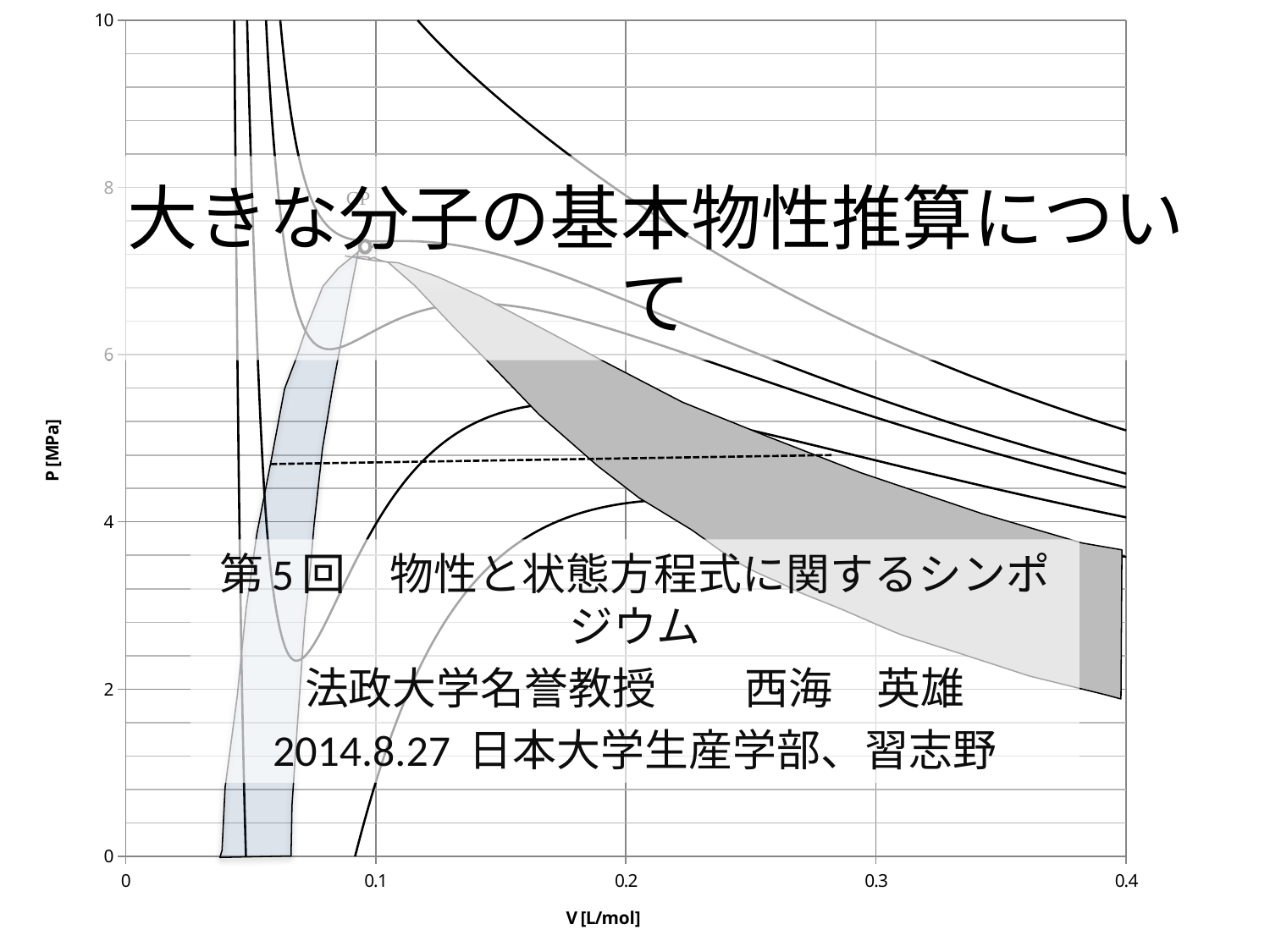
What kind of chart is shown on the slide? line chart What is the title of the horizontal axis of the chart? V [L/mol] Between V = 0.2 and V = 0.4, do the solid curves rise or fall as V increases? fall Is the pressure of the topmost solid curve at V = 0.4 greater or less than 4? greater What is the title of the vertical axis of the chart? P [MPa] Is the pressure of the lowest solid curve at V = 0.4 greater or less than 2? greater Is the pressure value of the horizontal dashed line greater or less than 4? greater